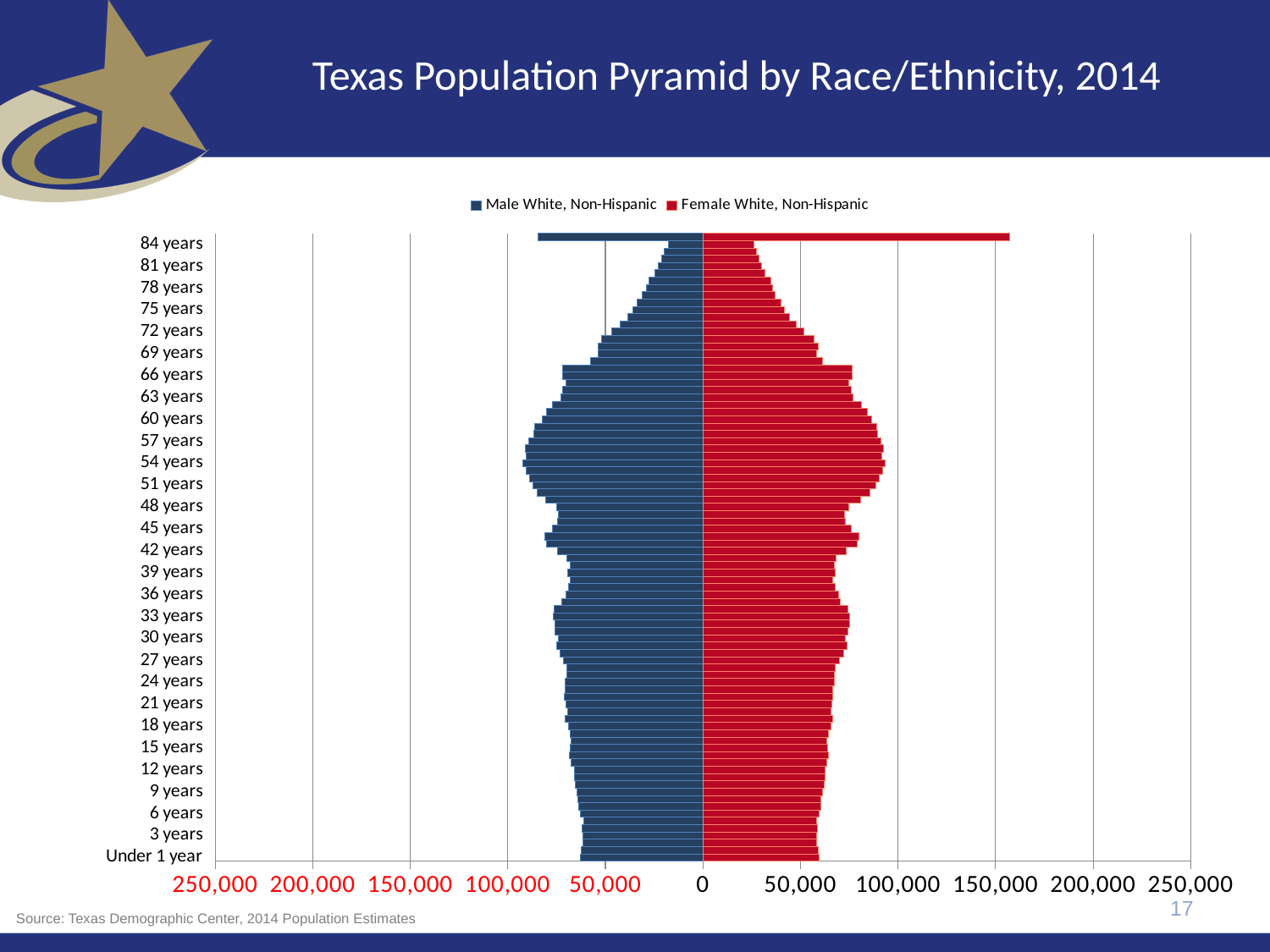
Is the Female White, Non-Hispanic value for 84 years greater or less than 100,000? less At 84 years, which is larger: the Male White, Non-Hispanic value or the Female White, Non-Hispanic value? Female White, Non-Hispanic What kind of chart is shown on the slide? Bar chart (population pyramid) Moving down the chart from 81 years to 66 years, do the Female White, Non-Hispanic bars get longer or shorter? longer Is the Male White, Non-Hispanic value for Under 1 year greater or less than 50,000? greater What is the title of the chart? Texas Population Pyramid by Race/Ethnicity, 2014 Is the Male White, Non-Hispanic value for 84 years greater or less than 100,000? less Which series is shown in red? Female White, Non-Hispanic How many series does the legend list? 2